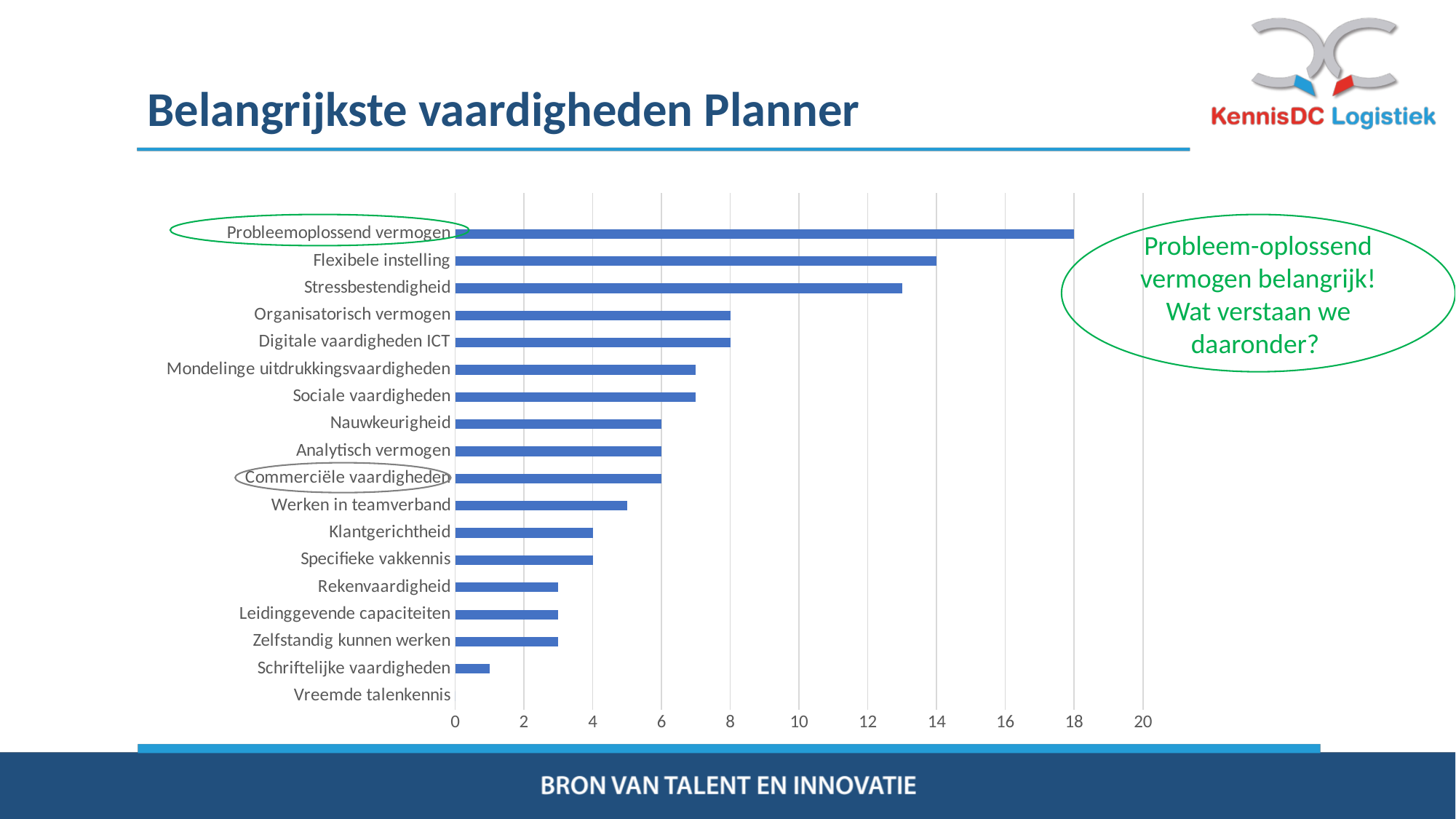
What is the value for Klantgerichtheid? 4 Is the value for Stressbestendigheid greater or less than 12? greater What is the difference between the values for Probleemoplossend vermogen and Flexibele instelling? 4 Which skill has the lowest value in the chart? Vreemde talenkennis What type of chart is shown on the slide? Bar chart What is the value for Flexibele instelling? 14 Which skill has the highest value in the chart? Probleemoplossend vermogen What is the value for Organisatorisch vermogen? 8 What is the value for Probleemoplossend vermogen? 18 Which has a larger value, Flexibele instelling or Organisatorisch vermogen? Flexibele instelling How many skills are listed in the chart? 18 Is the value for Schriftelijke vaardigheden greater or less than 2? less